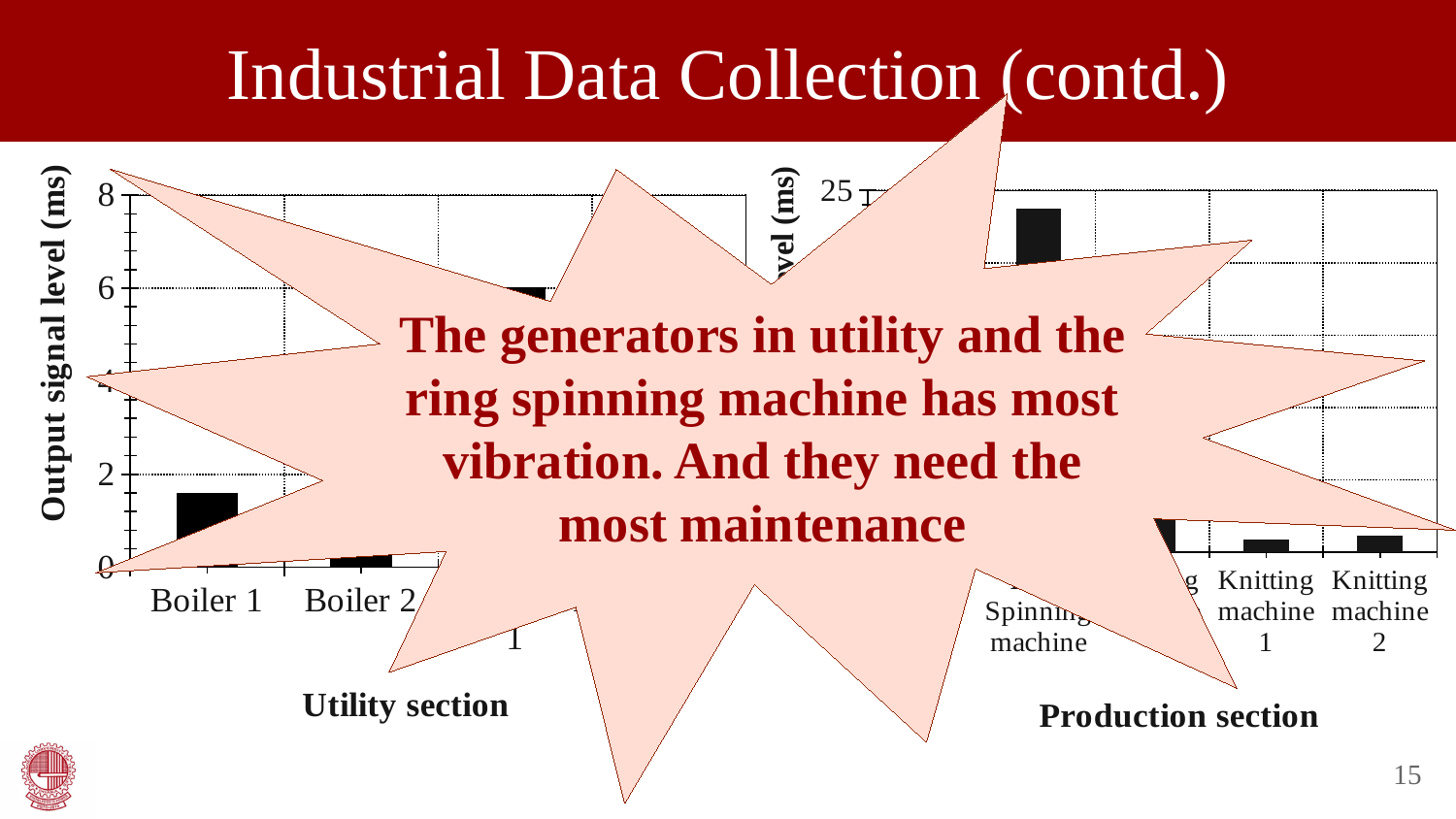
In the Utility section chart, is the value for Boiler 1 greater or less than 2? less In the Utility section chart, which has the larger value, Boiler 1 or Boiler 2? Boiler 1 In the Production section chart, which category has the highest bar? Ring Spinning machine What kind of chart is the Production section chart? bar chart What is the y-axis label of the Utility section chart? Output signal level (ms) What is the highest y-axis tick value shown on the Utility section chart? 8 In the Production section chart, is the value for Knitting machine 1 greater or less than 25? less In the Utility section chart, is the value for Boiler 2 greater or less than 2? less What kind of chart is the Utility section chart? bar chart